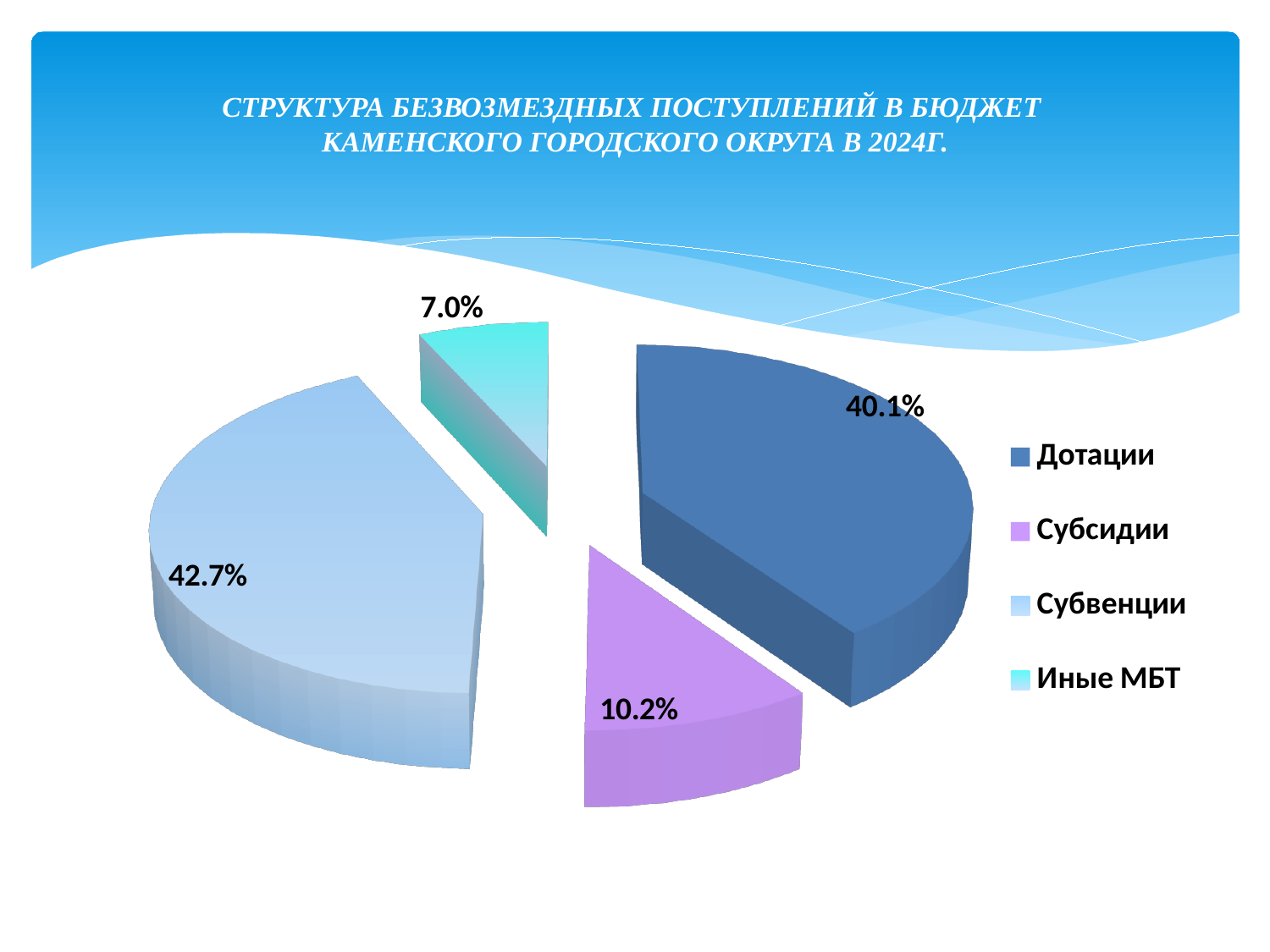
What share of the pie does Субвенции have? 42.7% What share of the pie does Дотации have? 40.1% How many slices does the pie chart have? 4 Which category has the largest share of the pie? Субвенции Which legend entry is shown in purple? Субсидии What share of the pie does Иные МБТ have? 7.0% Which category has the smallest share of the pie? Иные МБТ What is the difference in percentage points between Субсидии and Иные МБТ? 3.2 What share of the pie does Субсидии have? 10.2% What is the difference in percentage points between Субвенции and Дотации? 2.6 Which is larger, the share for Субсидии or the share for Иные МБТ? Субсидии What kind of chart is shown on the slide? pie chart